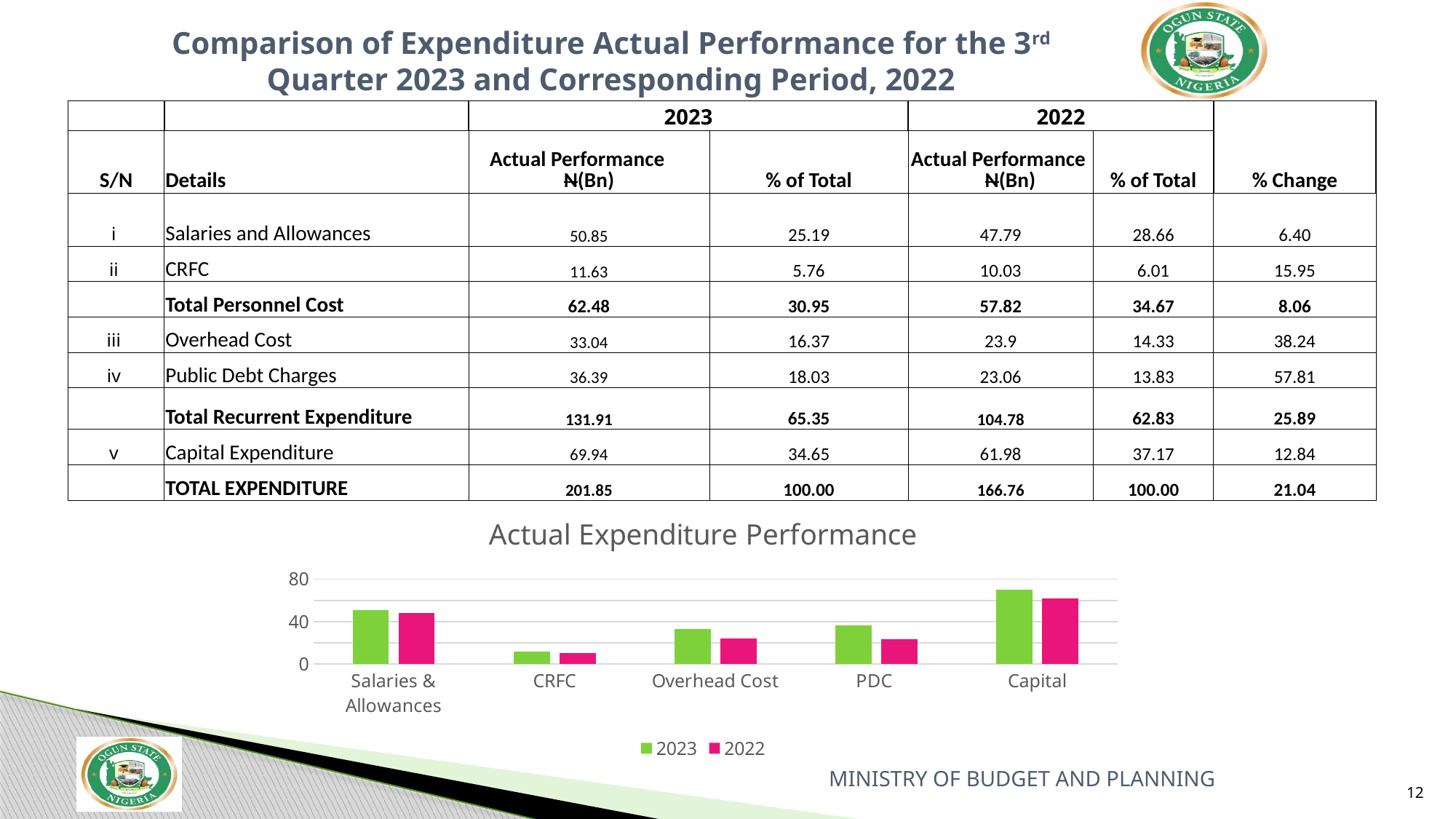
In the "Actual Expenditure Performance" chart, is the 2023 value for Salaries & Allowances greater or less than 40? greater In the "Actual Expenditure Performance" chart, which is larger for PDC: the 2023 bar or the 2022 bar? 2023 How many categories are shown on the x axis of the "Actual Expenditure Performance" chart? 5 In the "Actual Expenditure Performance" chart, which category has the lowest 2022 bar? CRFC In the "Actual Expenditure Performance" chart, is the 2023 value for Capital greater or less than 40? greater What kind of chart is shown under the title "Actual Expenditure Performance"? bar chart In the "Actual Expenditure Performance" chart, is the 2022 value for Overhead Cost greater or less than 40? less How many series does the legend of the "Actual Expenditure Performance" chart list? 2 In the "Actual Expenditure Performance" chart, which is larger for Overhead Cost: the 2023 bar or the 2022 bar? 2023 In the "Actual Expenditure Performance" chart, which category has the highest 2023 bar? Capital In the "Actual Expenditure Performance" chart, what colour are the 2022 bars? pink